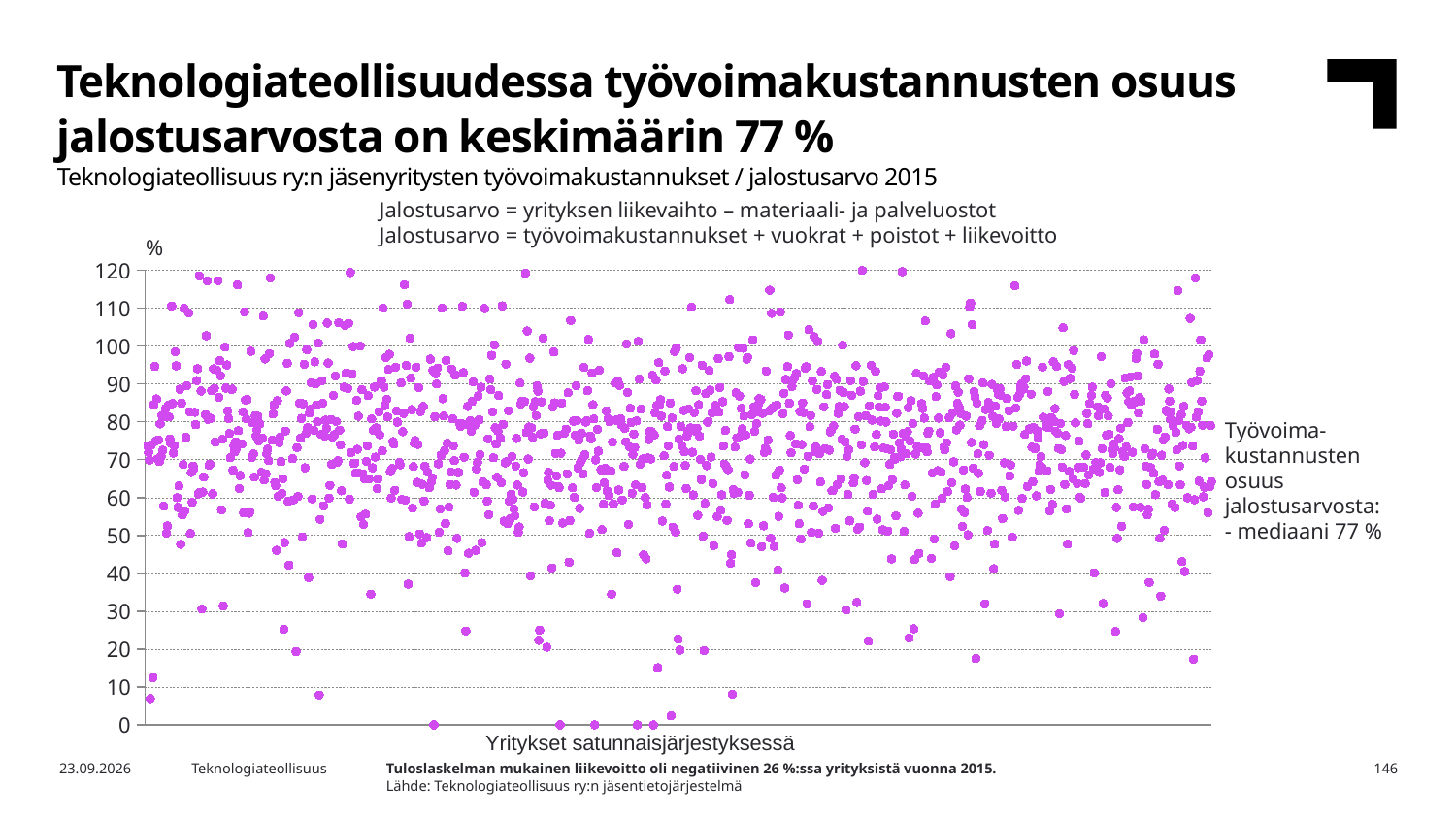
What kind of chart is shown on the slide? Scatter chart What unit is shown at the top of the vertical axis? % According to the annotation on the chart, what is the median share of labour costs in value added? 77 % What is the label of the horizontal axis of the chart? Yritykset satunnaisjärjestyksessä What is the highest value shown on the chart's vertical axis? 120 According to the note below the chart, in what share of companies was the operating profit negative in 2015? 26 %